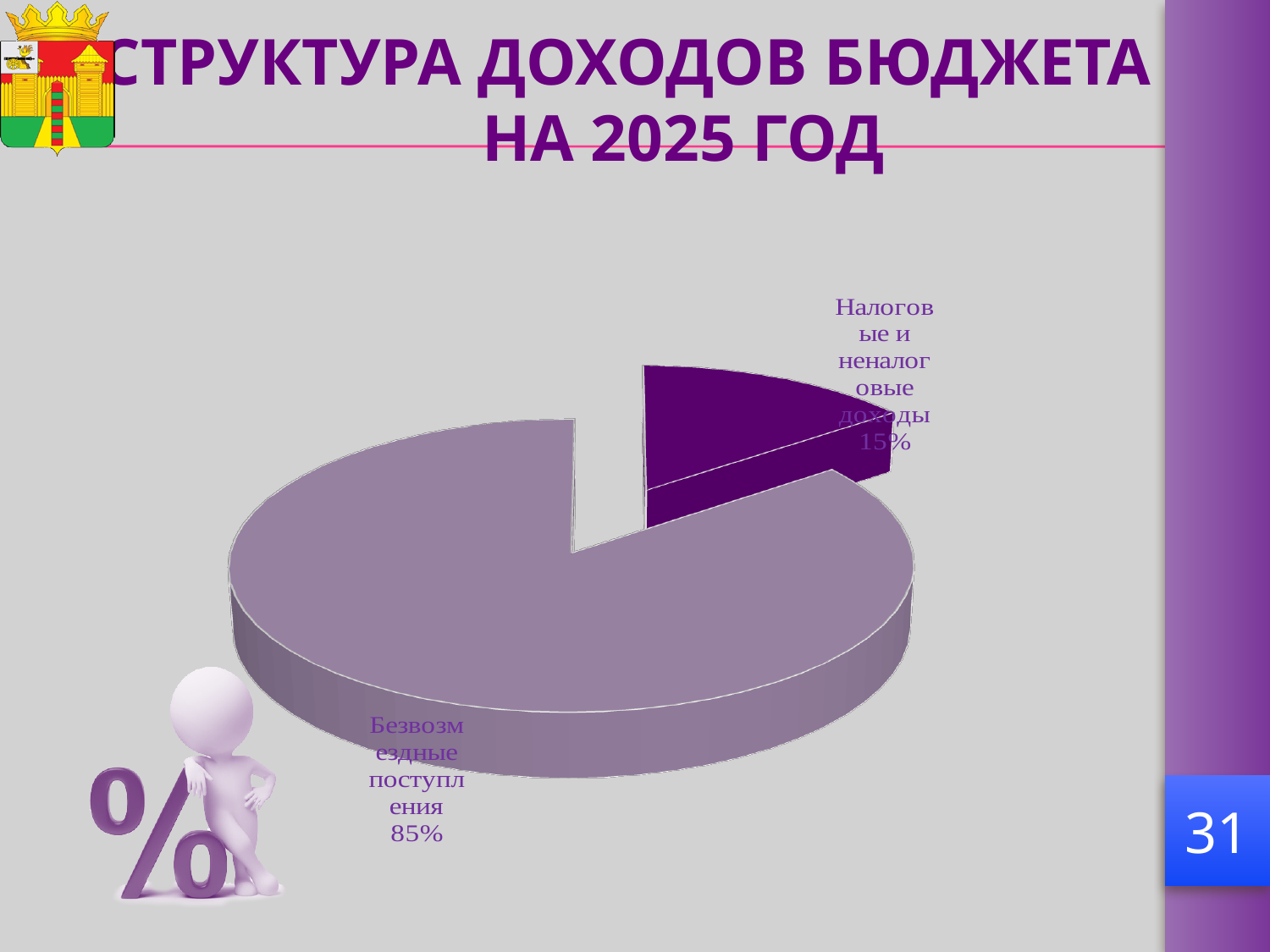
Which slice is the largest? Безвозмездные поступления What kind of chart is shown on the slide? pie chart What share of the pie does "Безвозмездные поступления" take? 85% How many slices does the pie chart have? 2 Which slice is pulled out (exploded) from the pie? Налоговые и неналоговые доходы What share of the pie does "Налоговые и неналоговые доходы" take? 15% Which is larger: "Безвозмездные поступления" or "Налоговые и неналоговые доходы"? Безвозмездные поступления What is the title of the slide containing the chart? СТРУКТУРА ДОХОДОВ БЮДЖЕТА НА 2025 ГОД Which slice is the smallest? Налоговые и неналоговые доходы What is the difference in percentage points between "Безвозмездные поступления" and "Налоговые и неналоговые доходы"? 70